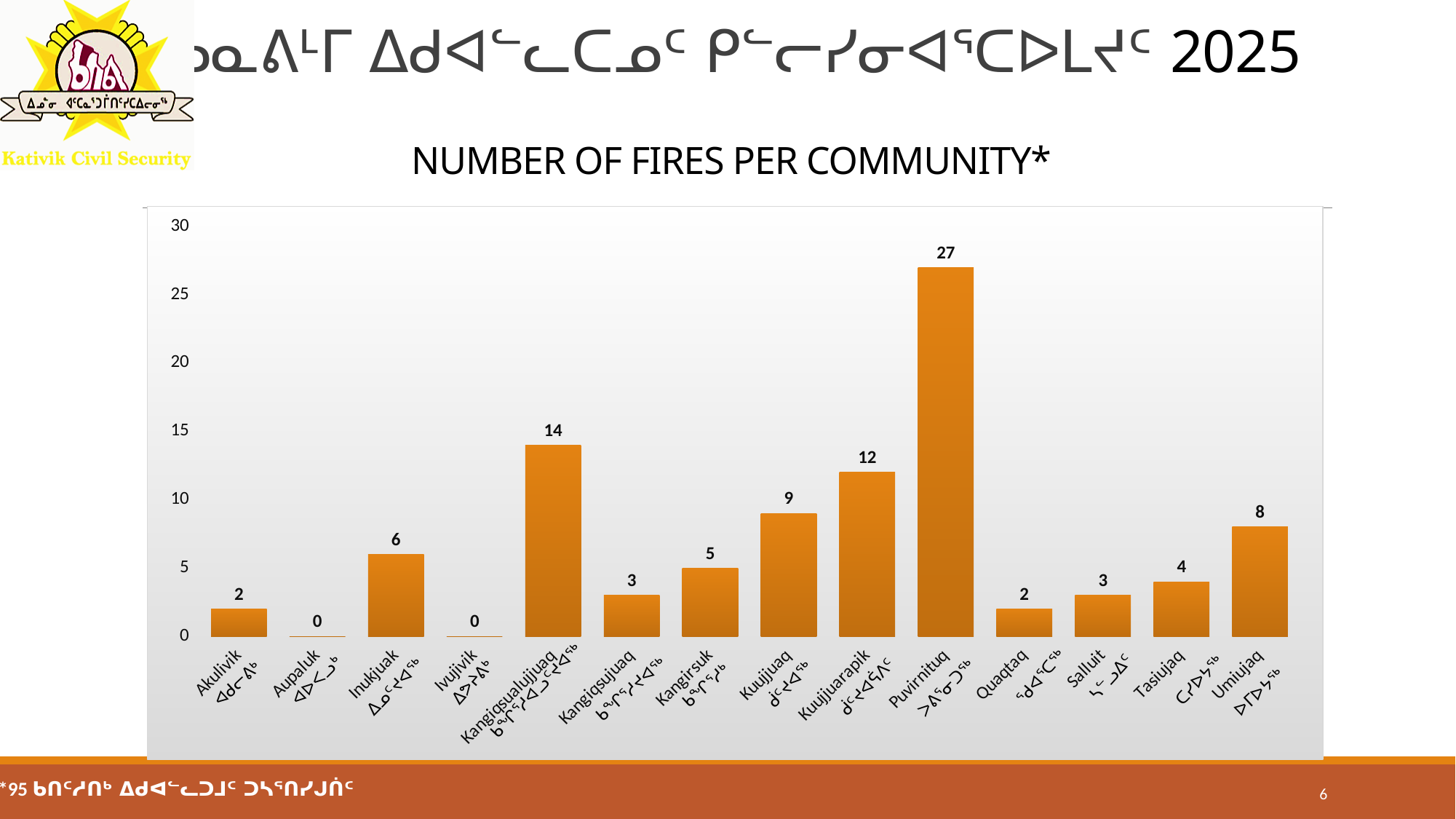
Which communities have 0 fires? Aupaluk and Ivujivik How many fires are shown for Umiujaq? 8 How many fires are shown for Puvirnituq? 27 Which has more fires, Kuujjuaq or Inukjuak? Kuujjuaq Is the value for Kangiqsualujjuaq greater or less than 10? greater What is the number of fires for Kangiqsualujjuaq? 14 What kind of chart is shown on the slide? Bar chart Which community has the highest number of fires? Puvirnituq What is the difference in the number of fires between Puvirnituq and Kuujjuarapik? 15 What is the title of the chart? NUMBER OF FIRES PER COMMUNITY* What is the highest value shown on the y axis? 30 How many communities are shown on the x axis? 14